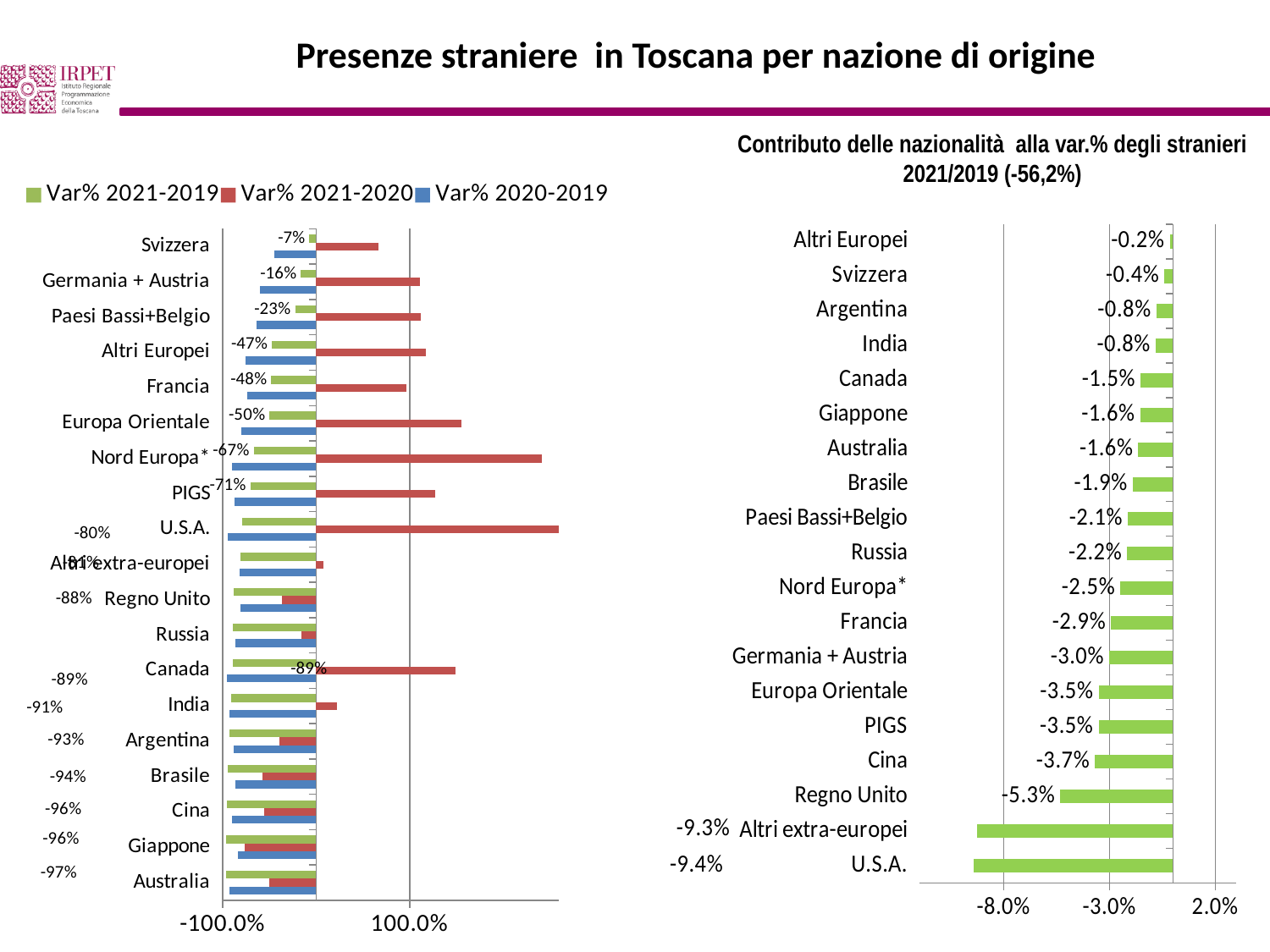
In the left chart (Var% by nation), which has a lower Var% 2021-2019 value, Francia or Germania + Austria? Francia What type of chart is the right chart (Contributo delle nazionalità)? Bar chart In the left chart (Var% by nation), is the Var% 2021-2020 value for Nord Europa* greater or less than 100%? greater In the right chart (Contributo delle nazionalità), what is the difference between the values for Regno Unito and Cina? 1.6 percentage points In the right chart (Contributo delle nazionalità), which category has the highest (least negative) value? Altri Europei In the right chart (Contributo delle nazionalità), what is the value for Cina? -3.7% In the right chart (Contributo delle nazionalità), how many categories are shown? 19 In the right chart (Contributo delle nazionalità), which category has the lowest (most negative) value? U.S.A. In the left chart (Var% by nation), how many series does the legend list? 3 In the left chart (Var% by nation), what is the Var% 2021-2019 value for Svizzera? -7% In the right chart (Contributo delle nazionalità alla var.% degli stranieri 2021/2019), what is the value for Regno Unito? -5.3% In the left chart (Var% by nation), what is the Var% 2021-2019 value for Europa Orientale? -50%